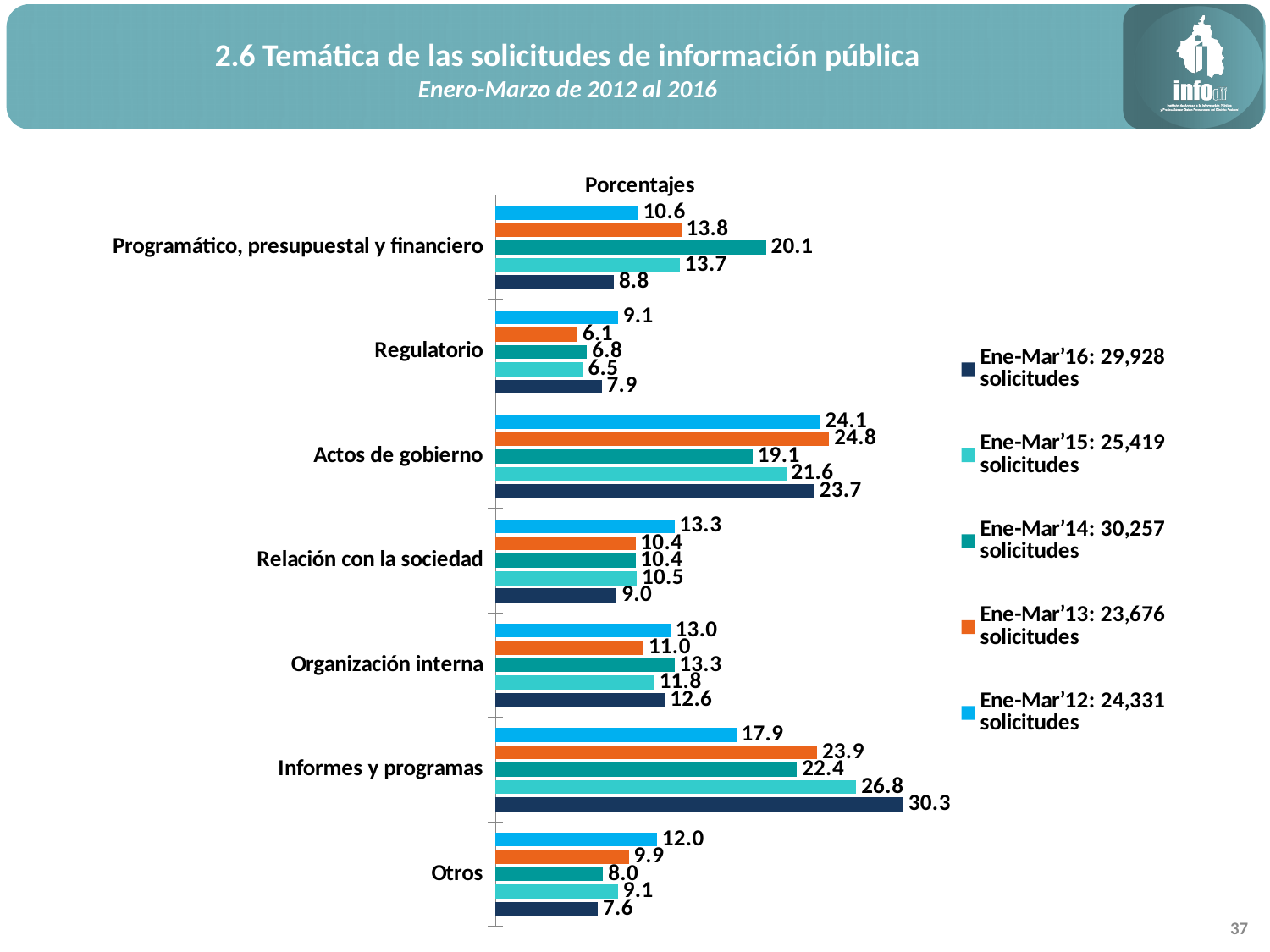
Which category has the lowest value in the Ene-Mar'13 series? Regulatorio According to the legend, how many solicitudes were there in Ene-Mar'14? 30,257 What kind of chart is shown on the slide? Bar chart What is the value for Informes y programas in the Ene-Mar'16 series? 30.3 How many series does the legend list? 5 What is the value for Regulatorio in the Ene-Mar'12 series? 9.1 What is the value for Programático, presupuestal y financiero in the Ene-Mar'14 series? 20.1 For Otros, which is larger: the Ene-Mar'12 value or the Ene-Mar'16 value? Ene-Mar'12 Which category has the highest value in the Ene-Mar'16 series? Informes y programas How many categories are shown on the chart? 7 What is the difference between the Ene-Mar'16 and Ene-Mar'12 values for Informes y programas? 12.4 What is the value for Actos de gobierno in the Ene-Mar'13 series? 24.8